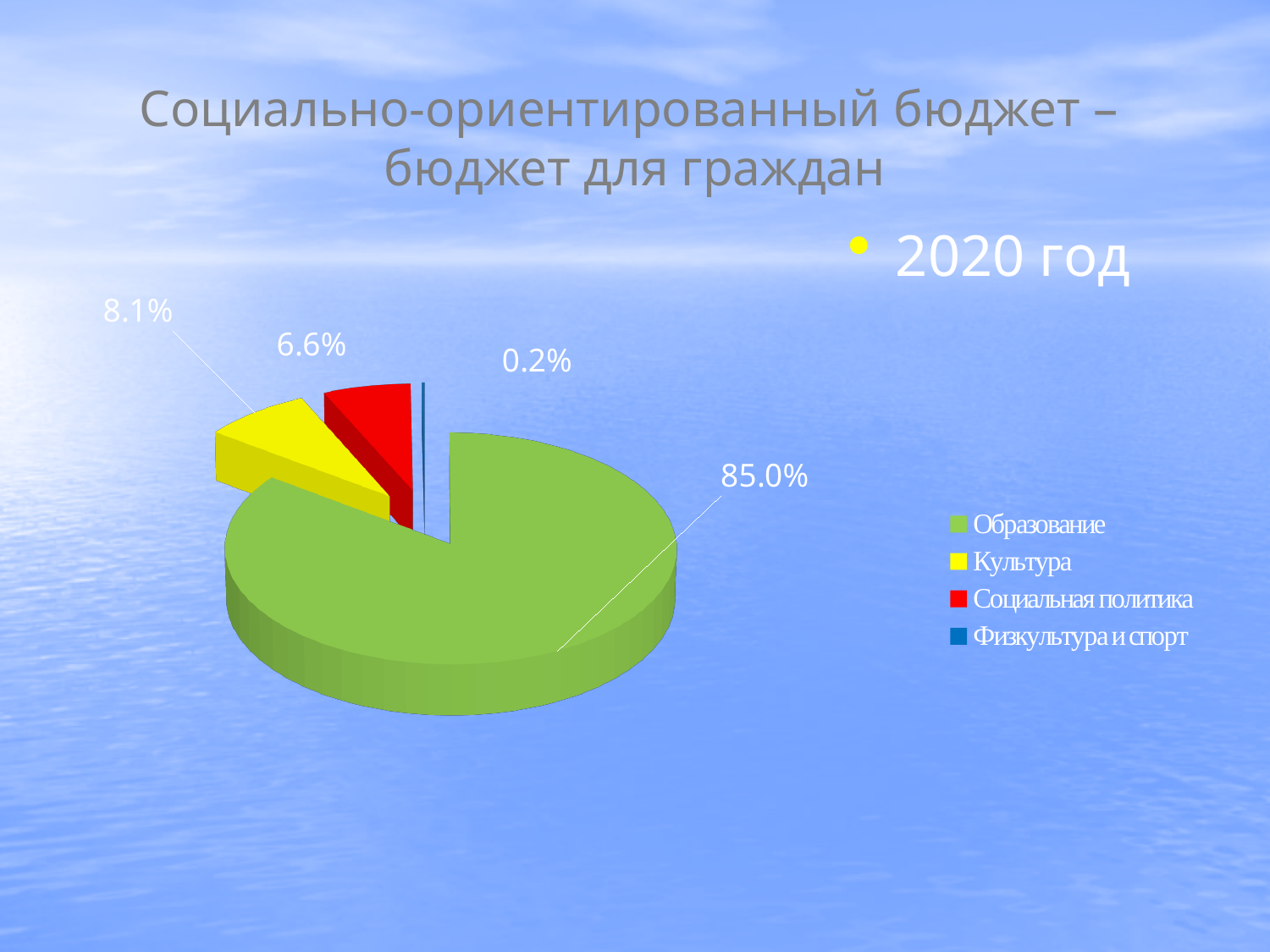
What is the difference in percentage points between Культура and Социальная политика? 1.5 Which year does the slide say the chart refers to? 2020 год What kind of chart is shown on the slide? pie chart What share of the pie does Образование have? 85.0% What colour is the slice for Социальная политика? red What share of the pie does Физкультура и спорт have? 0.2% Which is larger, the slice for Культура or the slice for Социальная политика? Культура How many categories does the pie chart show? 4 Which category has the smallest slice of the pie? Физкультура и спорт What share of the pie does Социальная политика have? 6.6% What share of the pie does Культура have? 8.1% Which category has the largest slice of the pie? Образование